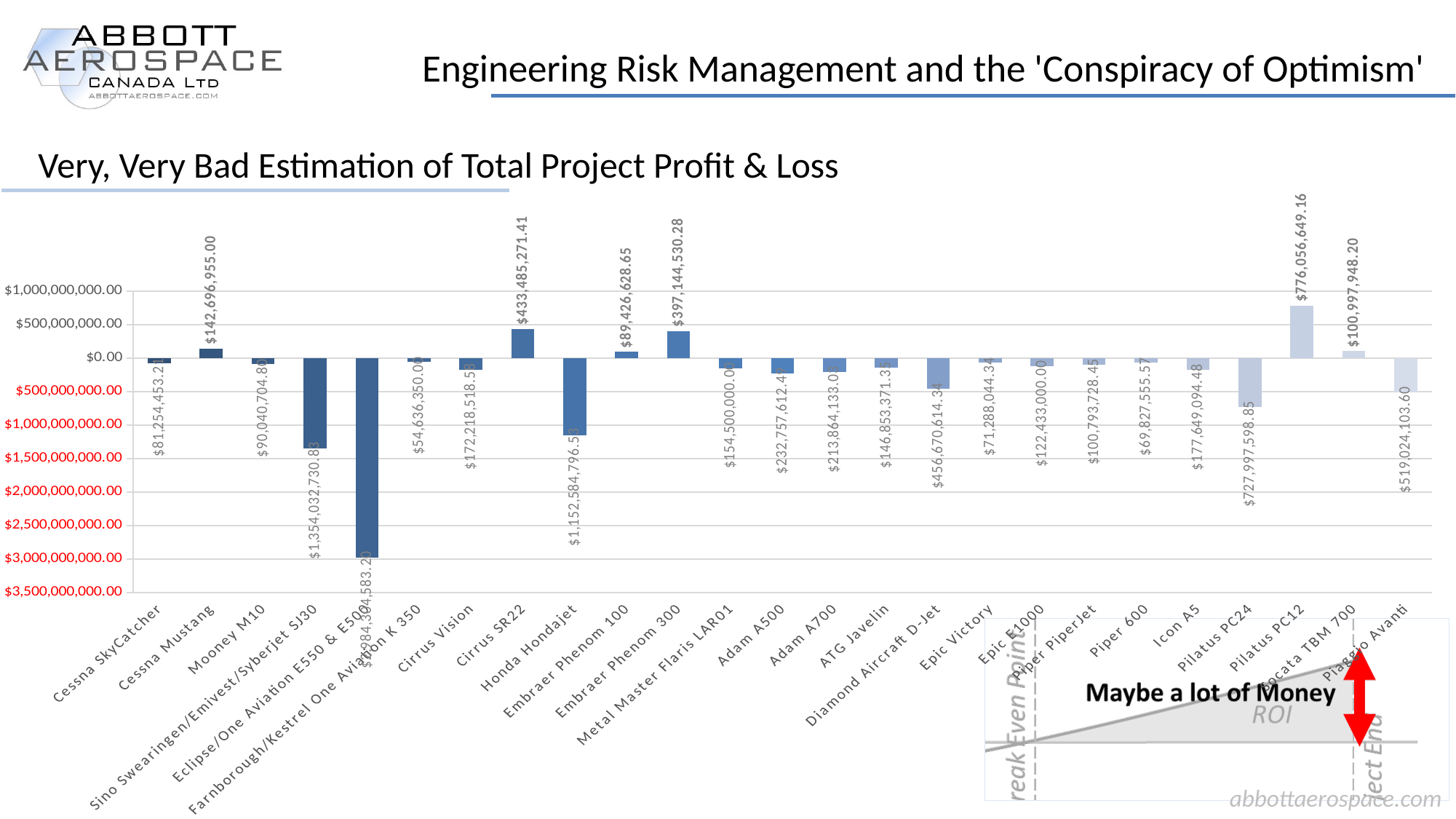
What is the value labelled on the Sino Swearingen/Emivest/Syberjet SJ30 bar? $1,354,032,730.83 How many aircraft programs are plotted on the chart? 25 What is the value shown for Cirrus SR22? $433,485,271.41 What is the value labelled on the Pilatus PC24 bar? $727,997,598.85 Which aircraft program has the lowest (most negative) value on the chart? Eclipse/One Aviation E550 & E500 Which bar extends further below zero, Pilatus PC24 or Piaggio Avanti? Pilatus PC24 What is the title of the chart? Very, Very Bad Estimation of Total Project Profit & Loss What is the value shown for Pilatus PC12? $776,056,649.16 What is the value shown for Embraer Phenom 300? $397,144,530.28 What is the difference between the values for Pilatus PC12 and Cirrus SR22? $342,571,377.75 What type of chart is shown on the slide? bar chart Which aircraft program has the highest (most positive) value on the chart? Pilatus PC12